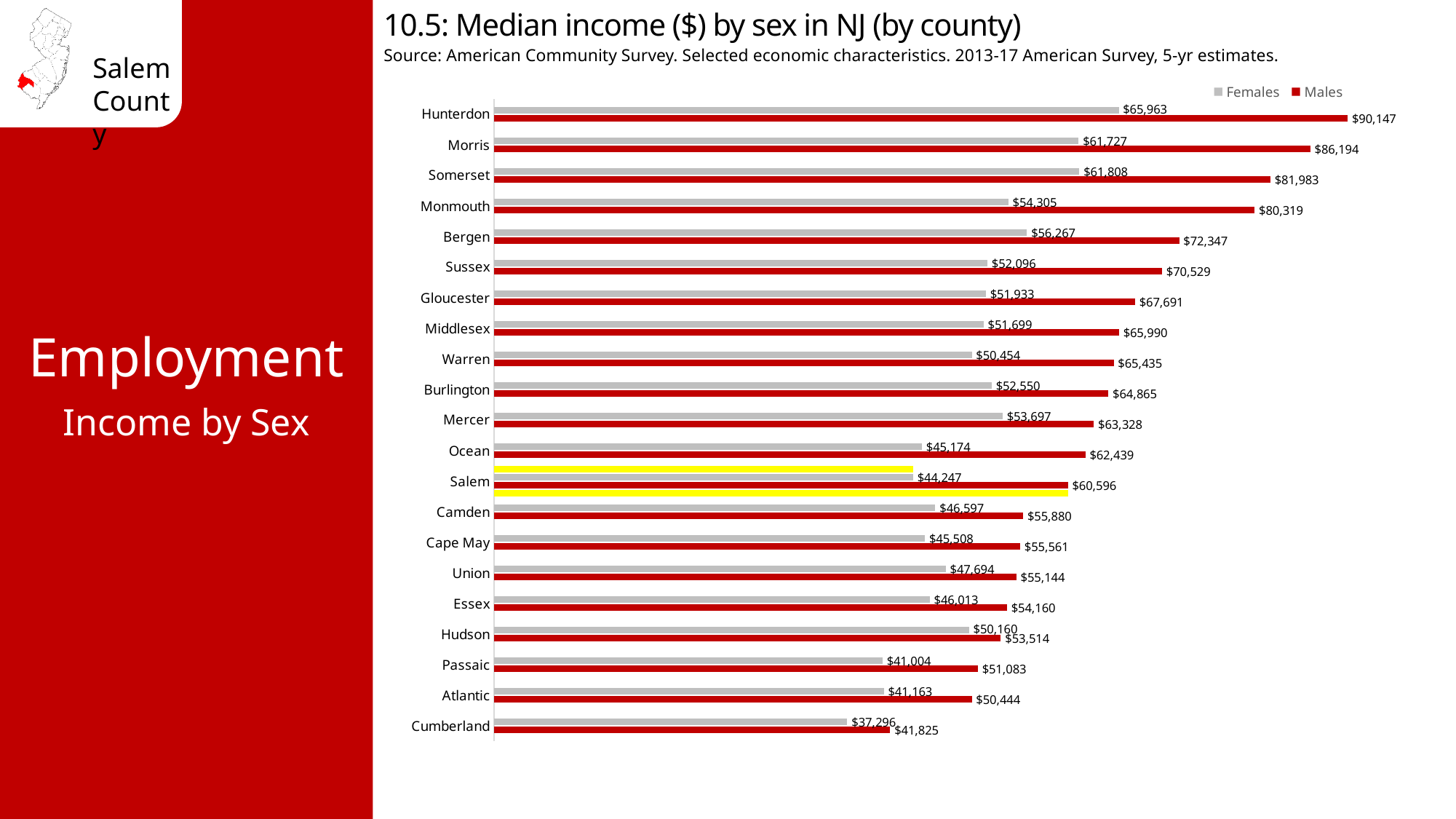
How many series does the legend list? 2 Which is larger, the female median income in Morris county or in Somerset county? Somerset How many counties are shown in the chart? 21 What is the median income for females in Salem county? $44,247 Which county has the lowest median income for males? Cumberland What is the difference between the male and female median income in Hunterdon county? $24,184 What kind of chart is shown on the slide? Bar chart What is the median income for females in Cumberland county? $37,296 Which county has the highest median income for females? Hunterdon What is the median income for males in Salem county? $60,596 What is the median income for males in Hunterdon county? $90,147 What is the difference between the male and female median income in Salem county? $16,349